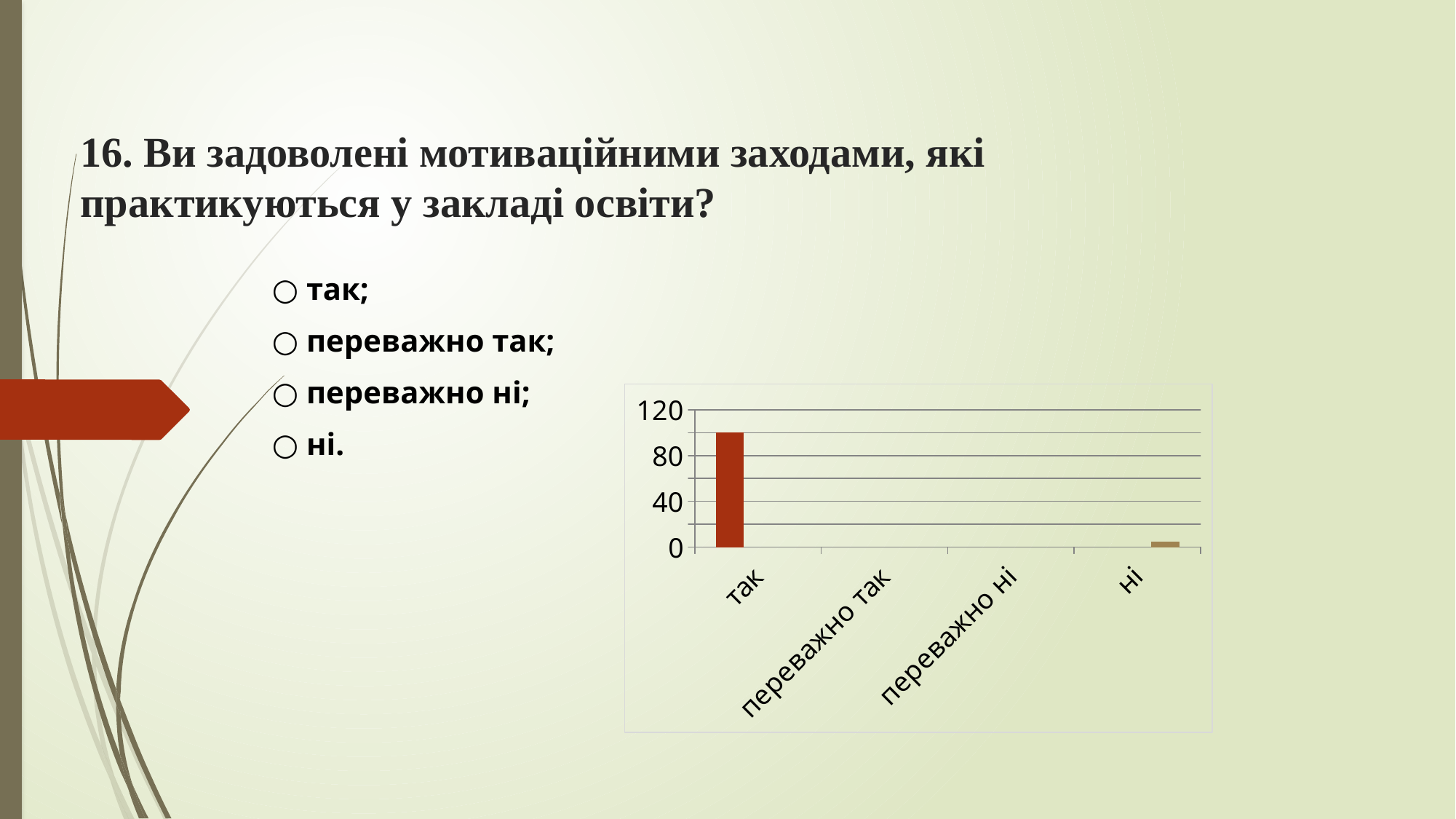
Is the value for ні greater or less than 40? less What is the highest value shown on the vertical axis of the chart? 120 Which is larger, the value for так or the value for ні? так Which category has the highest bar in the chart? так What kind of chart is shown on the slide? bar chart What colour is the bar for так? dark red How many categories are shown on the x axis of the chart? 4 Is the value for так greater or less than 80? greater Is the value for так greater or less than 120? less